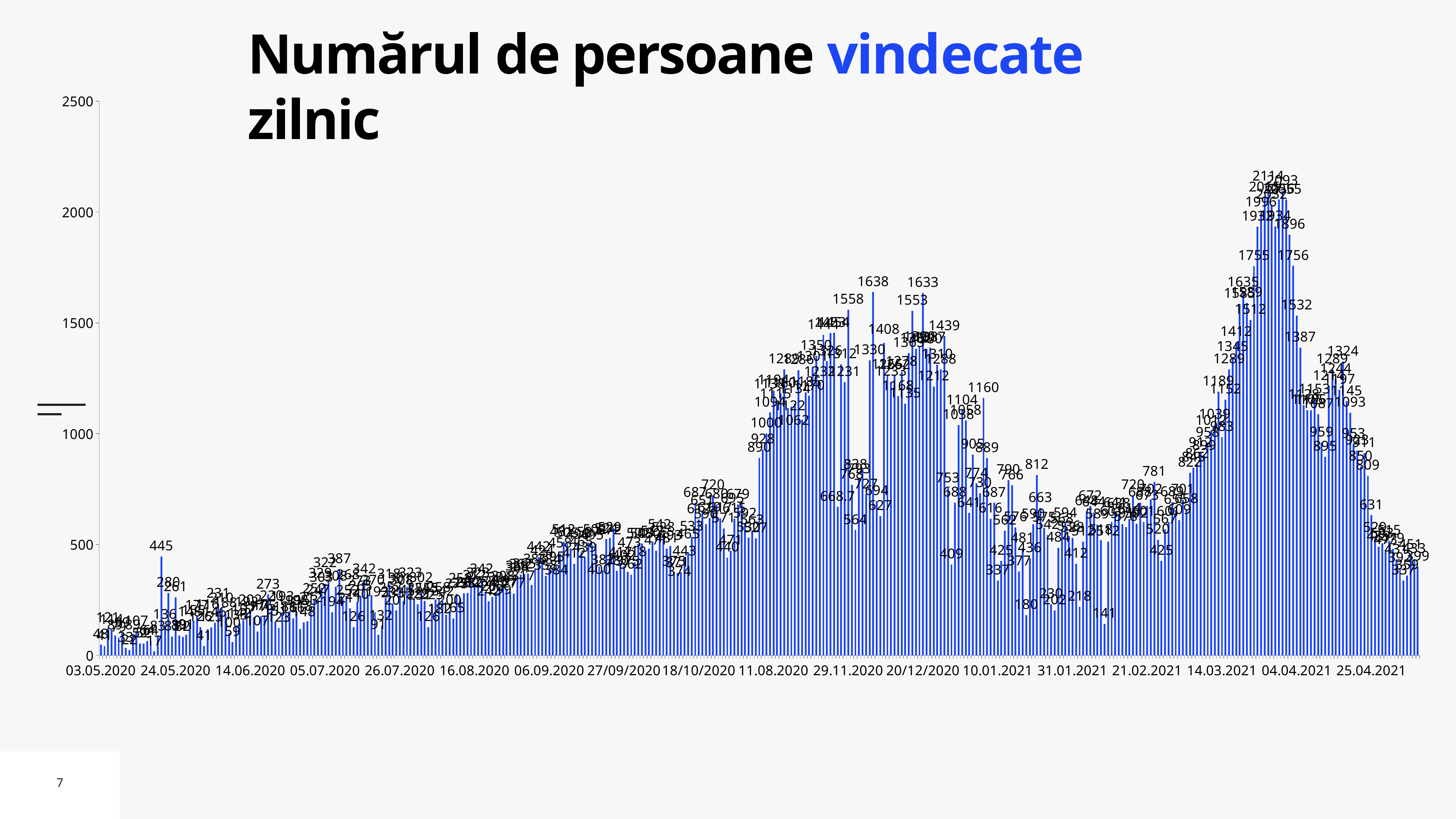
What kind of chart is shown on the slide? bar chart What is the maximum value shown on the vertical axis? 2500 What is the highest value labelled in the November–December 2020 peak? 1638 Do the values rise or fall between 04.04.2021 and 25.04.2021? fall Is the value for 04.04.2021 greater or less than 1500? greater What is the highest value labelled on the chart? 2114 Is the value for 14.06.2020 greater or less than 500? less Is the value for 31.01.2021 greater or less than 1000? less What is the title of the chart? Numărul de persoane vindecate zilnic Which is larger, the highest value of the April 2021 peak (2114) or the highest value of the November 2020 peak (1638)? 2114 Do the values rise or fall between 21.02.2021 and 04.04.2021? rise What is the value of the isolated spike shortly before 24.05.2020? 445